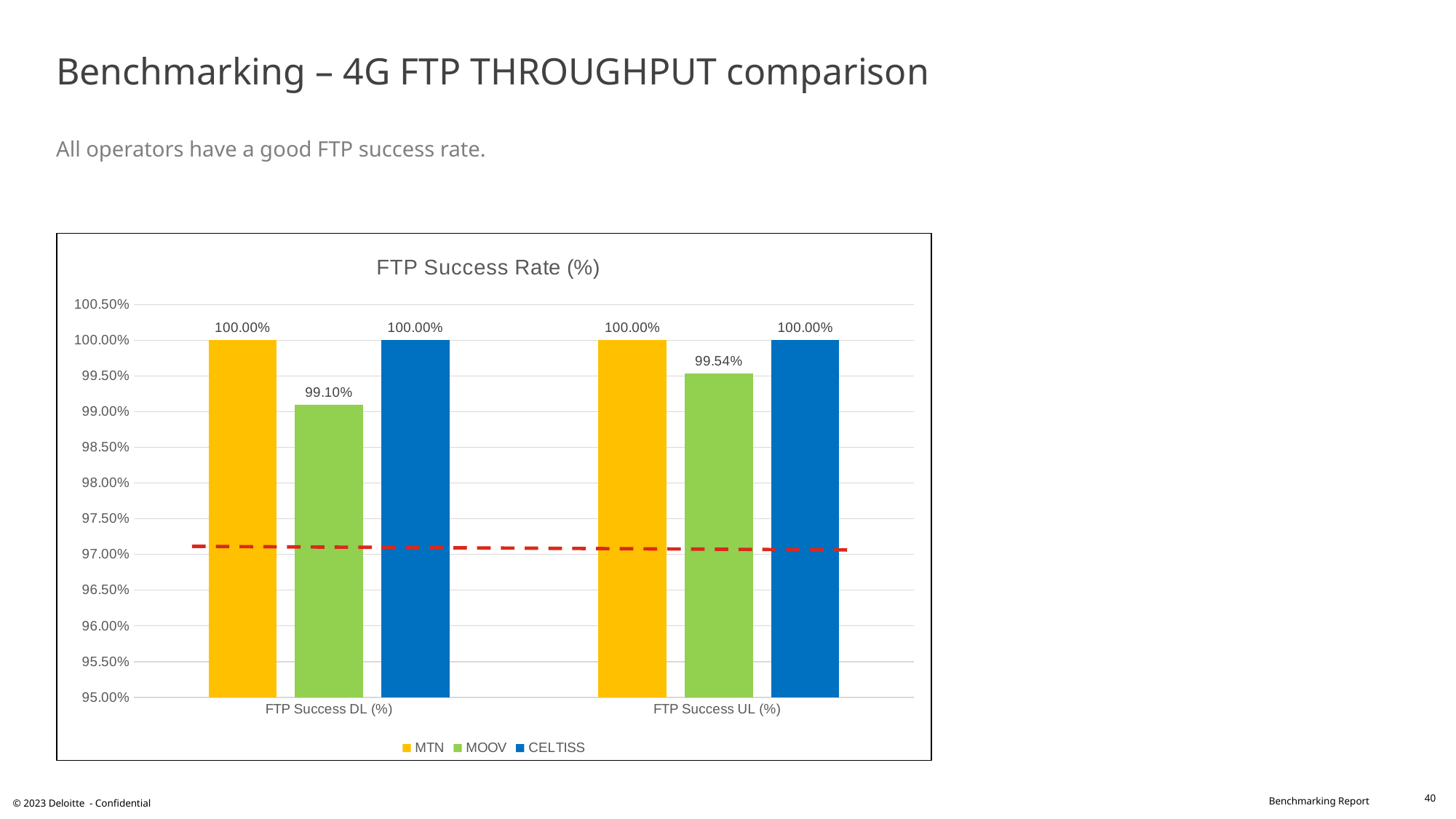
What is the FTP Success DL (%) value for MOOV? 99.10% What kind of chart is shown on the slide? Bar chart What is the FTP Success UL (%) value for CELTISS? 100.00% What is the difference between MOOV's FTP Success UL (%) and FTP Success DL (%) values? 0.44% What is the title of the chart? FTP Success Rate (%) What is the FTP Success UL (%) value for MOOV? 99.54% Which is larger: MOOV's FTP Success DL (%) or MOOV's FTP Success UL (%)? FTP Success UL (%) Which operator has the lowest FTP Success UL (%)? MOOV What is the FTP Success DL (%) value for MTN? 100.00% How many series does the legend list? 3 Which operator has the lowest FTP Success DL (%)? MOOV What is the difference between MTN's and MOOV's FTP Success DL (%) values? 0.90%